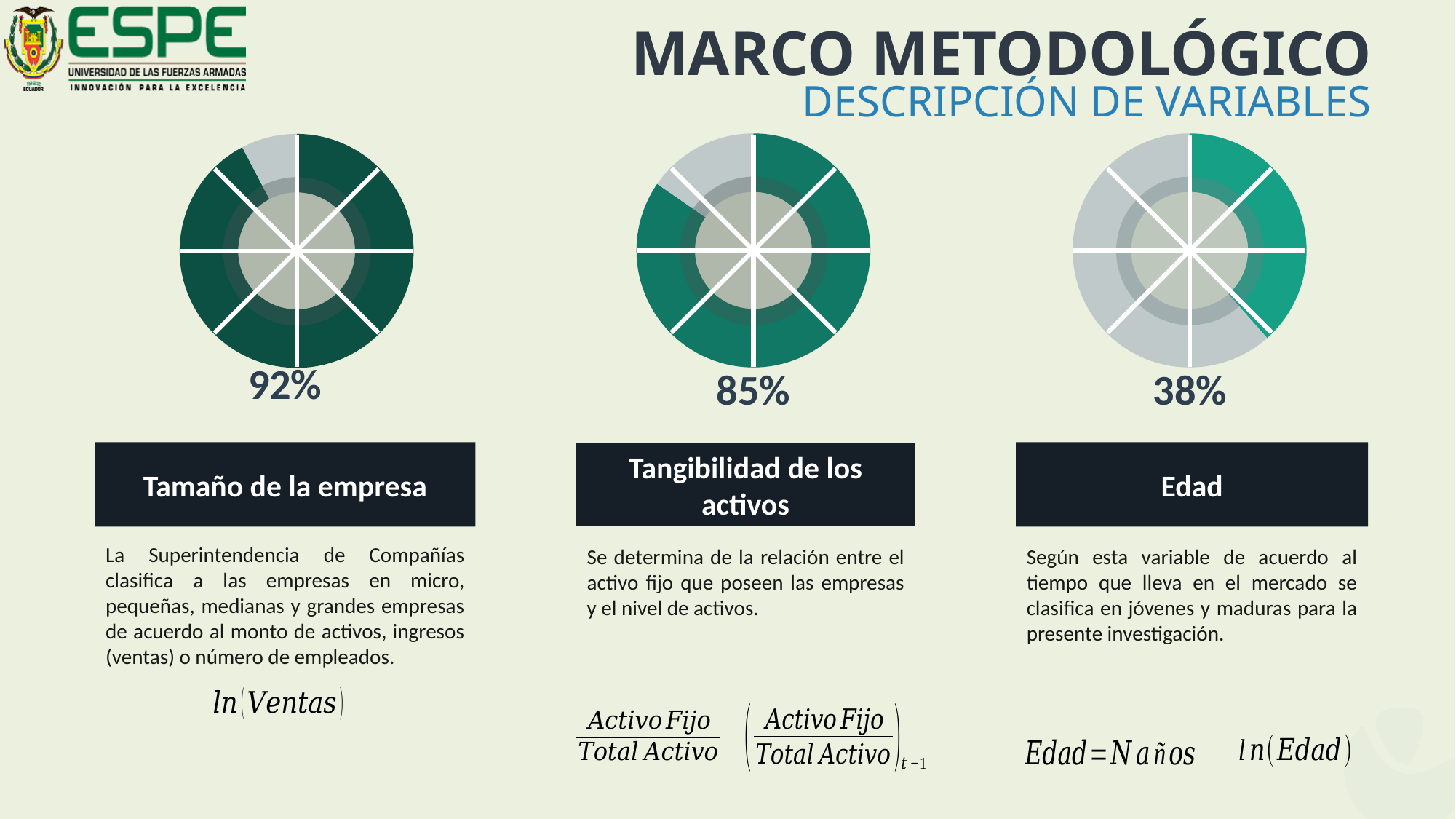
What percentage is shown below the right chart labelled 'Edad'? 38% What percentage is shown below the left chart labelled 'Tamaño de la empresa'? 92% Which of the three variables has the lowest percentage shown? Edad What is the difference between the percentage for 'Tamaño de la empresa' and the percentage for 'Tangibilidad de los activos'? 7 percentage points Which has a larger percentage, 'Tangibilidad de los activos' or 'Edad'? Tangibilidad de los activos Which variable's chart is positioned on the far right of the slide? Edad Is the percentage shown for 'Edad' greater or less than 50%? less What percentage is shown below the middle chart labelled 'Tangibilidad de los activos'? 85% What kind of chart is used to display the percentages on this slide? Donut (pie) chart How many circular charts are shown on the slide? 3 Which of the three variables has the highest percentage shown? Tamaño de la empresa What is the difference between the percentage for 'Tamaño de la empresa' and the percentage for 'Edad'? 54 percentage points